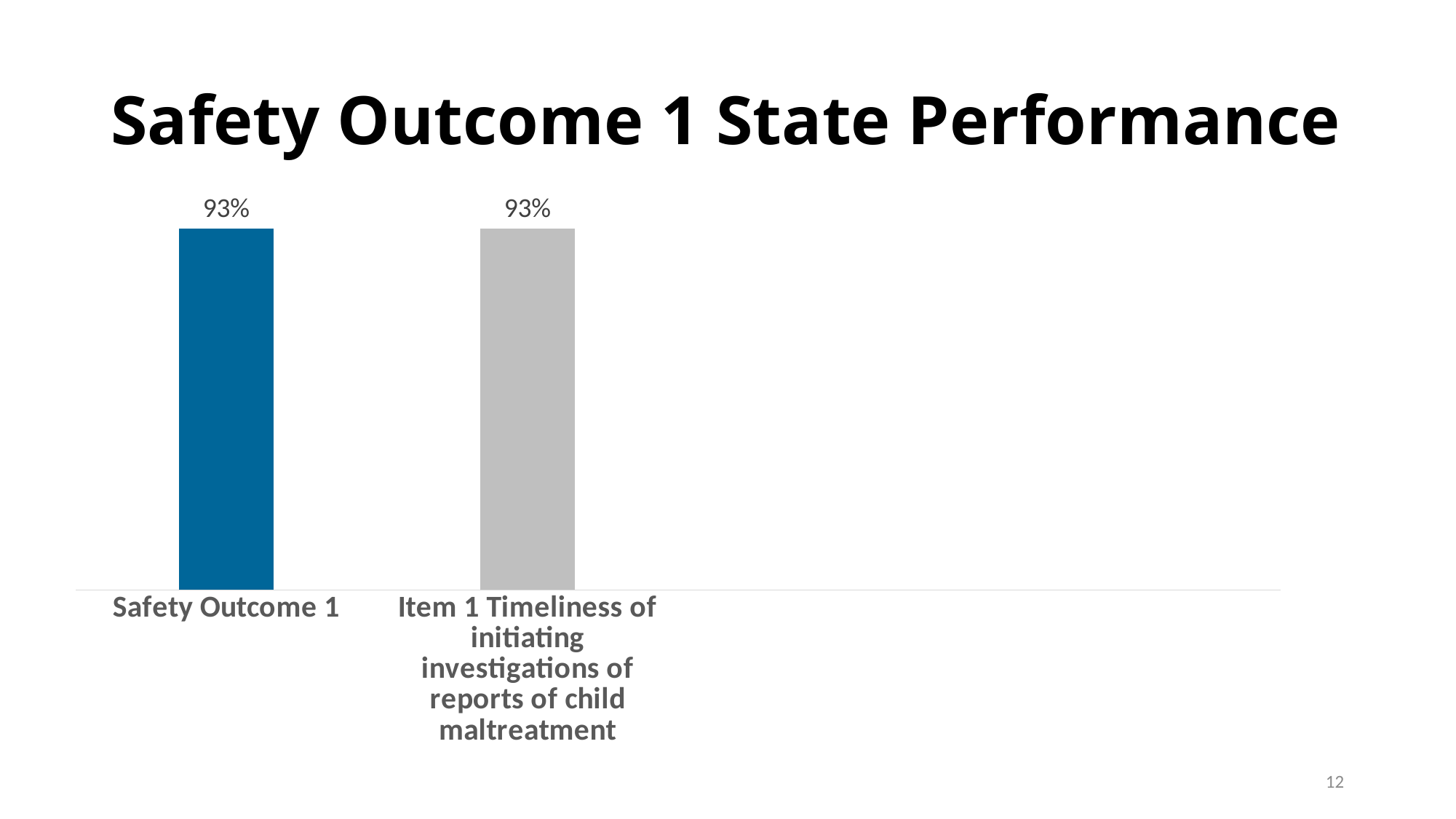
What is the value for Item 1 Timeliness of initiating investigations of reports of child maltreatment? 93% What colour is the bar for Safety Outcome 1? blue Do the two bars on the chart have the same value? yes What is the difference between the value for Safety Outcome 1 and the value for Item 1 Timeliness of initiating investigations of reports of child maltreatment? 0% How many bars are plotted on the chart? 2 What is the title of the slide? Safety Outcome 1 State Performance What kind of chart is shown on the slide? bar chart What is the value for Safety Outcome 1? 93%